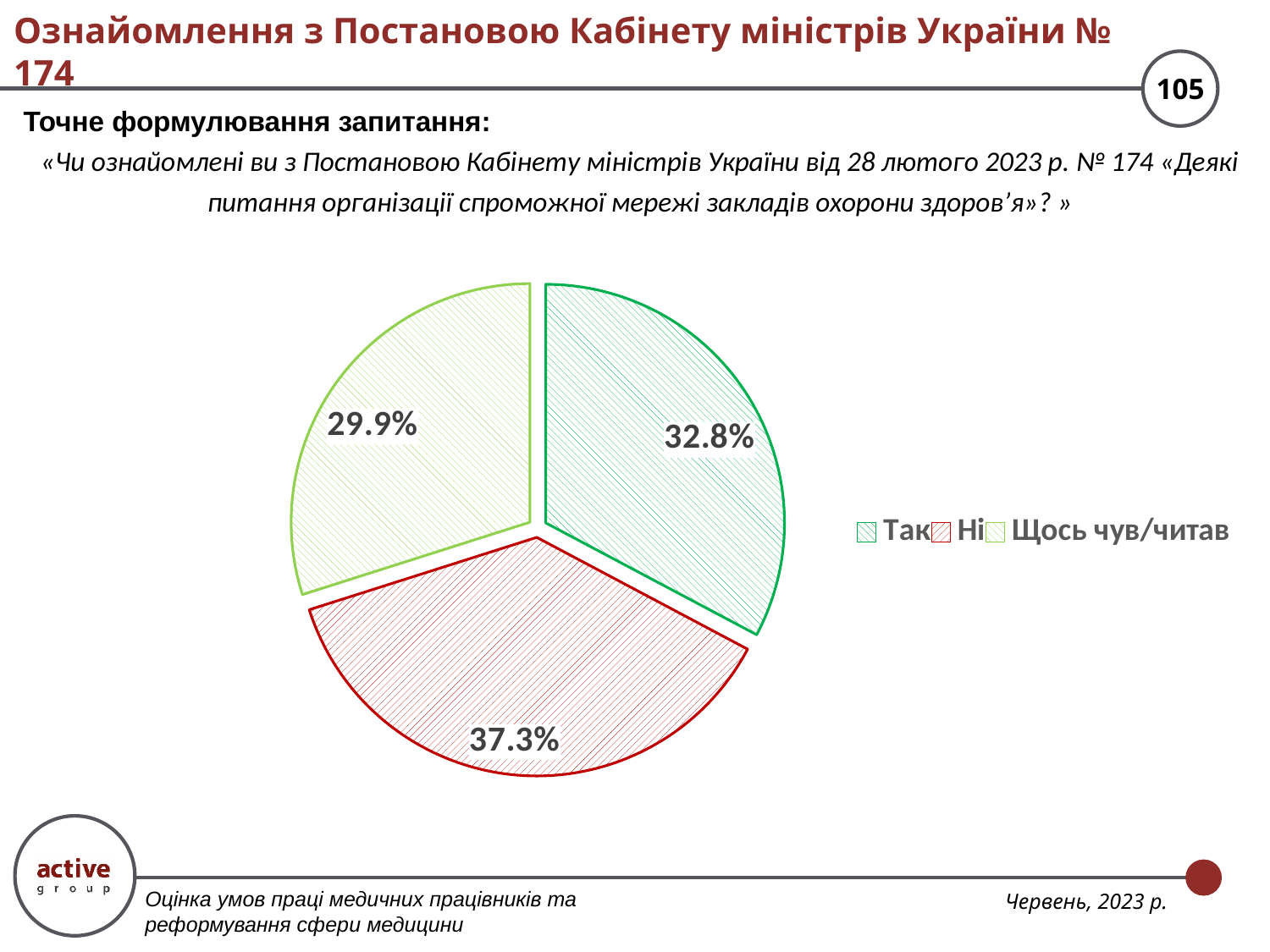
What colour is the slice for "Ні"? red What is the difference in percentage points between the "Так" share and the "Щось чув/читав" share? 2.9 What share of respondents answered "Щось чув/читав"? 29.9% Which is larger: the share for "Так" or the share for "Ні"? Ні What kind of chart is shown on the slide? pie chart What share of respondents answered "Ні"? 37.3% How many slices does the pie chart have? 3 Which answer has the largest share of the pie? Ні What share of respondents answered "Так"? 32.8% What is the difference in percentage points between the "Ні" share and the "Так" share? 4.5 How many entries does the legend list? 3 Which answer has the smallest share of the pie? Щось чув/читав